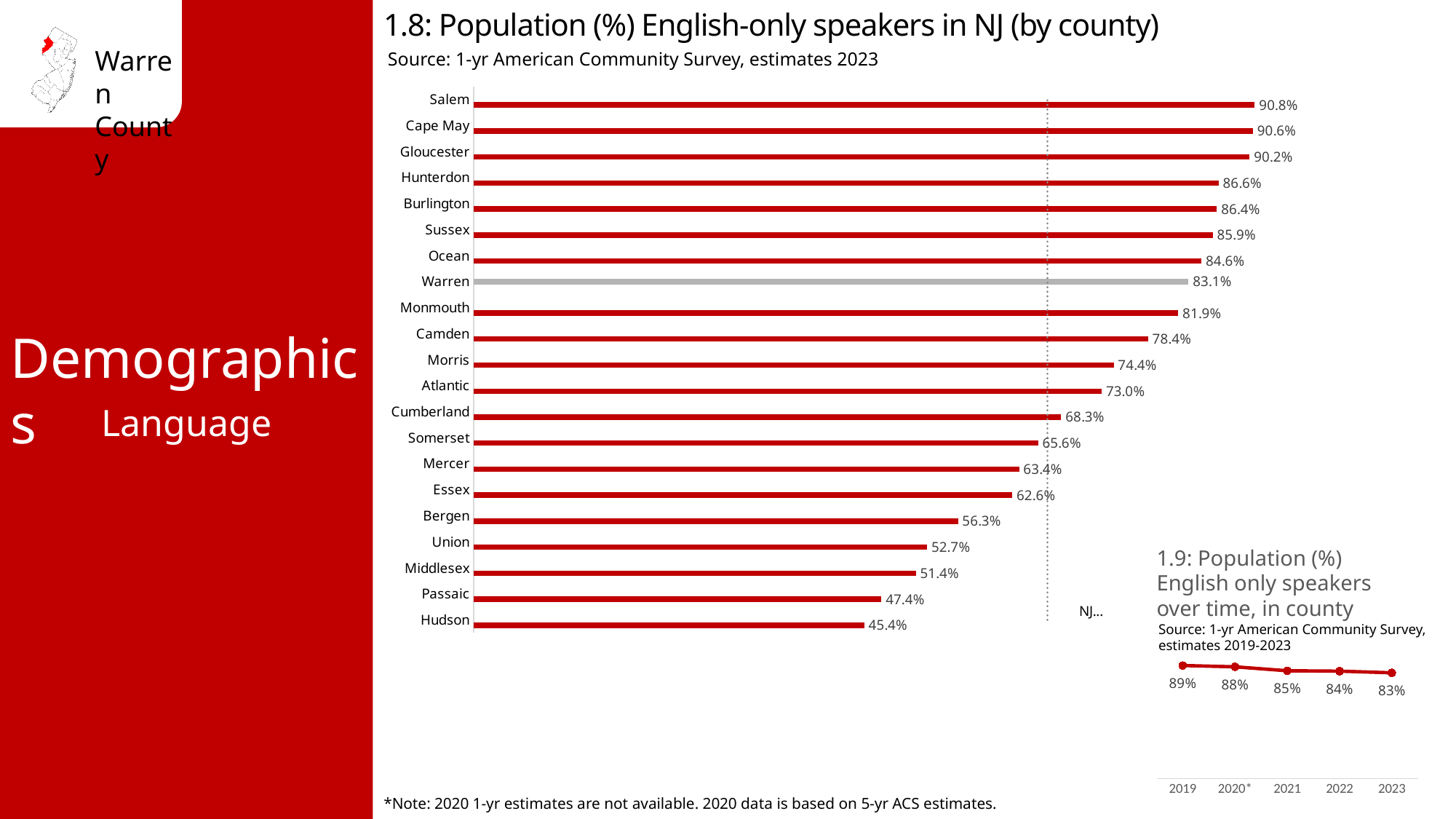
In chart 1.8 (Population (%) English-only speakers in NJ by county), what is the value for Warren? 83.1% In chart 1.9, what is the difference between the 2019 and 2023 values? 6% In chart 1.9, do the values rise or fall from 2019 to 2023? Fall In chart 1.8, what is the value for Passaic? 47.4% In chart 1.8, which has a higher value, Morris or Atlantic? Morris In chart 1.9 (Population (%) English only speakers over time, in county), what is the value for 2019? 89% What kind of chart is chart 1.8? Bar chart In chart 1.8, which county has the highest percentage of English-only speakers? Salem In chart 1.8, how many counties are shown? 21 In chart 1.8, what is the value for Monmouth? 81.9% In chart 1.8, what is the difference between the values for Salem and Hudson? 45.4% In chart 1.8, which county has the lowest percentage of English-only speakers? Hudson